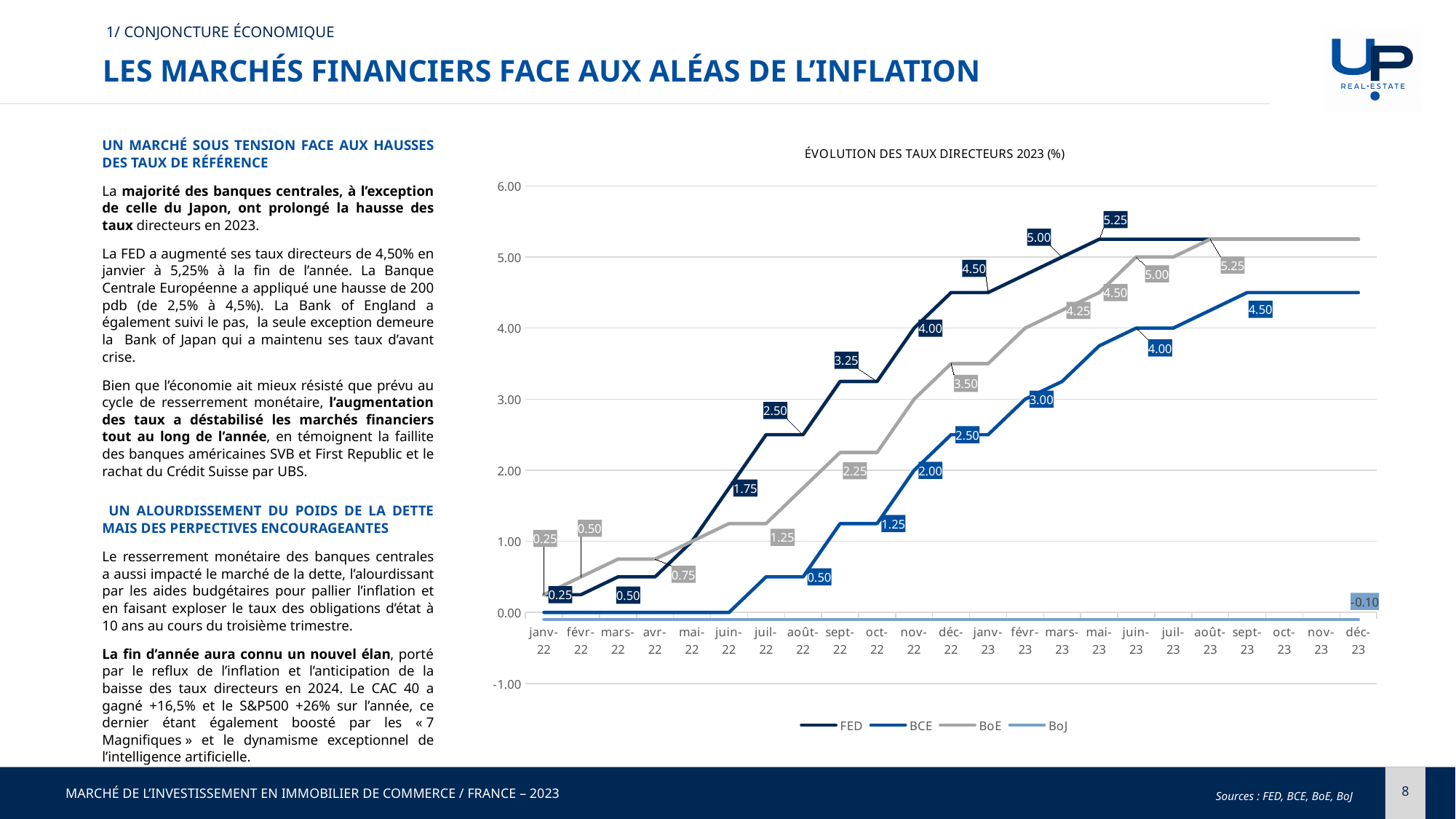
What is the value labeled for BoJ at déc-23? -0.10 What is the last value labeled on the BCE line? 4.50 What is the highest value labeled on the BoE line? 5.25 How many series does the legend of the chart list? 4 At déc-23, which is higher, the FED line or the BCE line? FED What is the difference between the final FED value (5.25) and the final BCE value (4.50)? 0.75 Does the FED line rise or fall from janv-22 to déc-23? rise What is the highest value labeled on the FED line? 5.25 How many months are shown on the x axis of the chart? 23 Which series does the legend list in the chart? FED, BCE, BoE, BoJ What kind of chart is shown on the slide? line chart Which series has the lowest value at déc-23? BoJ